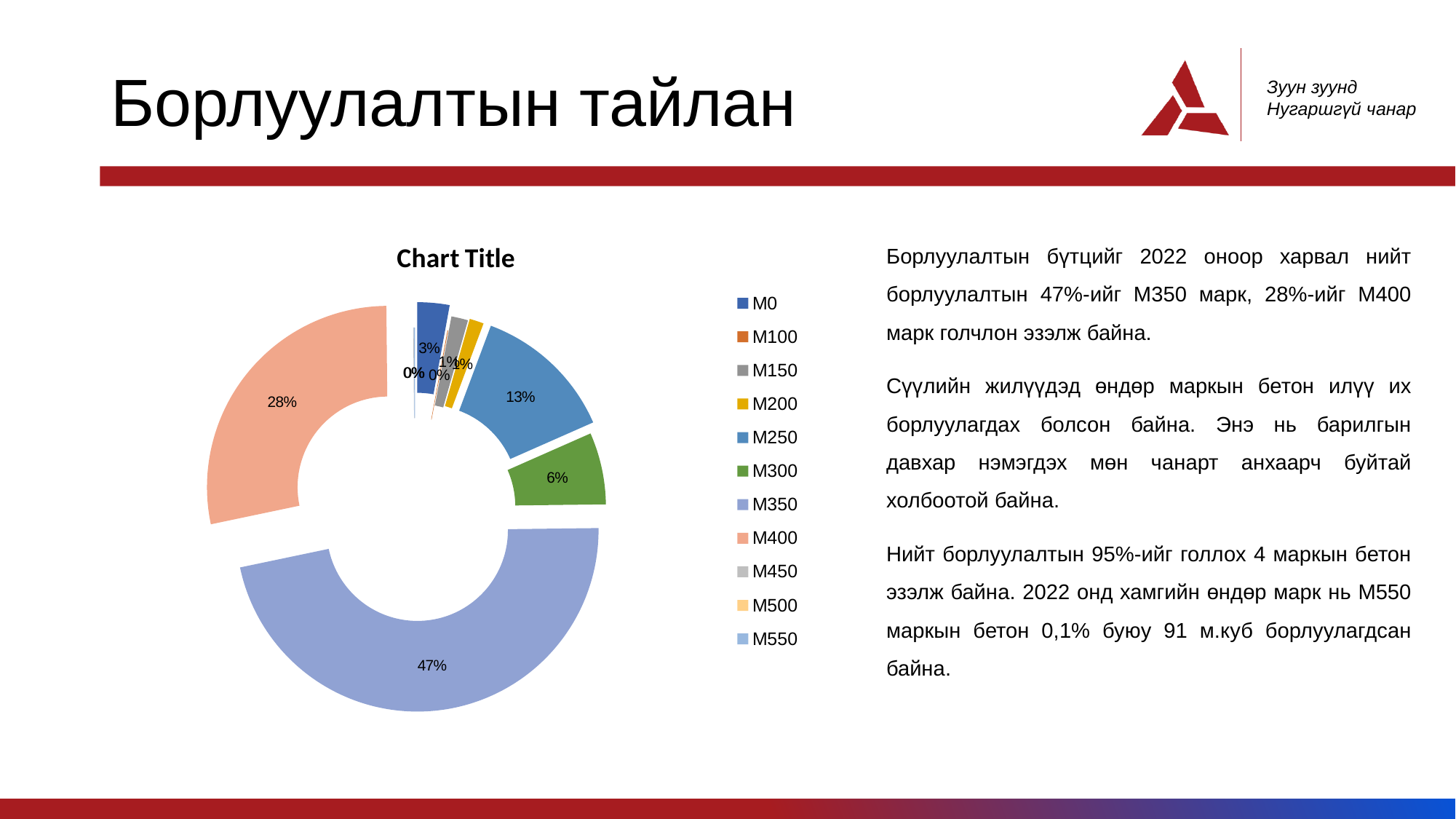
How many categories does the legend list? 11 What share of the pie does M400 hold? 28% What is the title of the chart? Chart Title What share of the pie does M300 hold? 6% What is the difference in percentage points between the M350 and M400 slices? 19 percentage points Which category has the largest slice of the pie? M350 Which slice is larger, M0 or M300? M300 What kind of chart is shown on the slide? pie chart (doughnut) Which slice is larger, M250 or M300? M250 What share of the pie does M250 hold? 13% What share of the pie does M350 hold? 47% What share of the pie does M0 hold? 3%